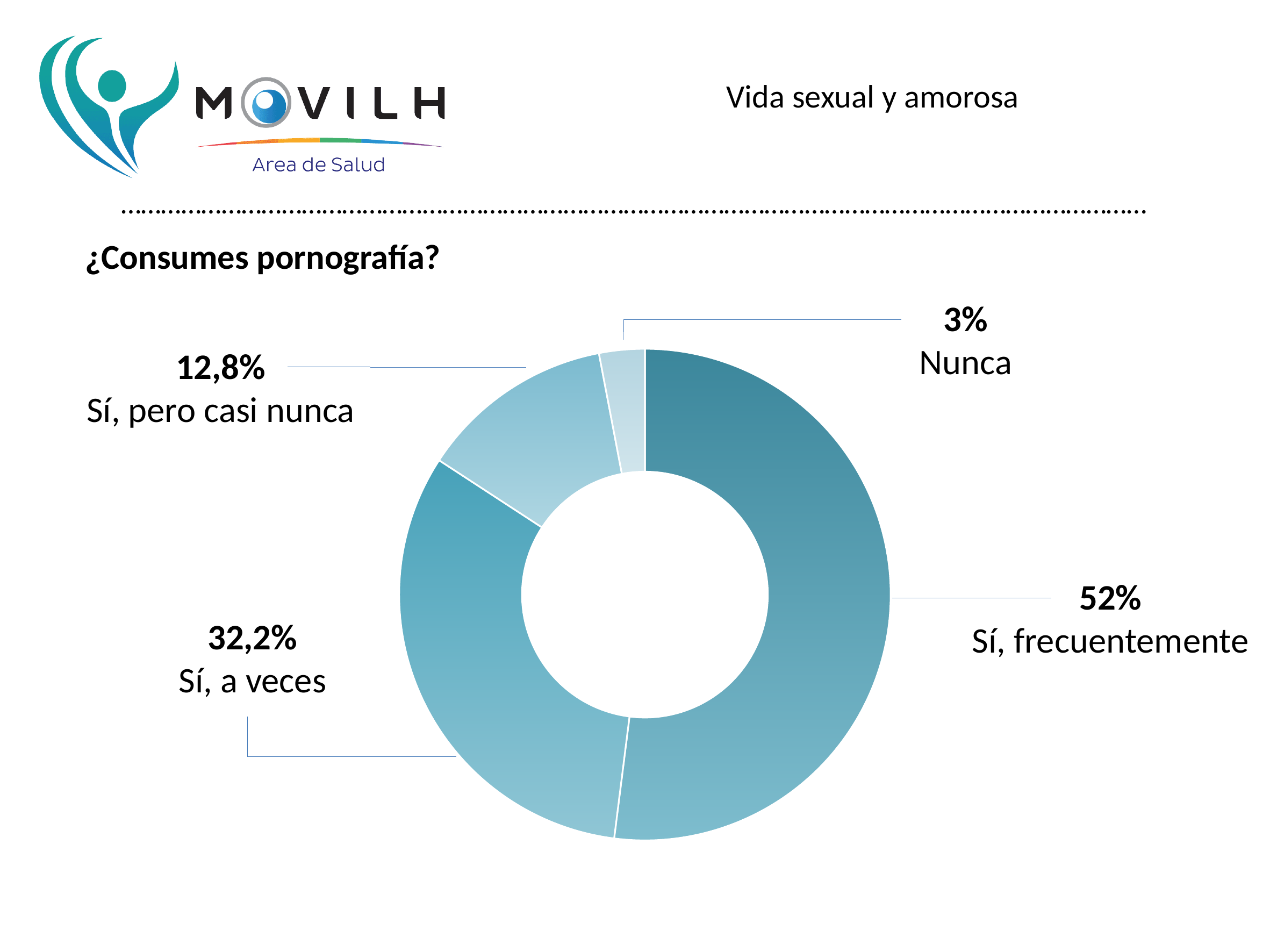
Which response has the smallest share of the chart? Nunca What is the difference in percentage points between "Sí, frecuentemente" and "Sí, a veces"? 19,8 Which is larger: the share for "Sí, pero casi nunca" or the share for "Nunca"? Sí, pero casi nunca What percentage of respondents answered "Sí, frecuentemente" to "¿Consumes pornografía?"? 52% What percentage of respondents answered "Nunca"? 3% What percentage of respondents answered "Sí, a veces"? 32,2% Which response has the largest share of the chart? Sí, frecuentemente What kind of chart is used on this slide? Doughnut (pie) chart What is the combined percentage of "Sí, a veces" and "Sí, pero casi nunca"? 45% What percentage of respondents answered "Sí, pero casi nunca"? 12,8% How many response categories are shown in the chart? 4 What question does the chart on this slide answer? ¿Consumes pornografía?